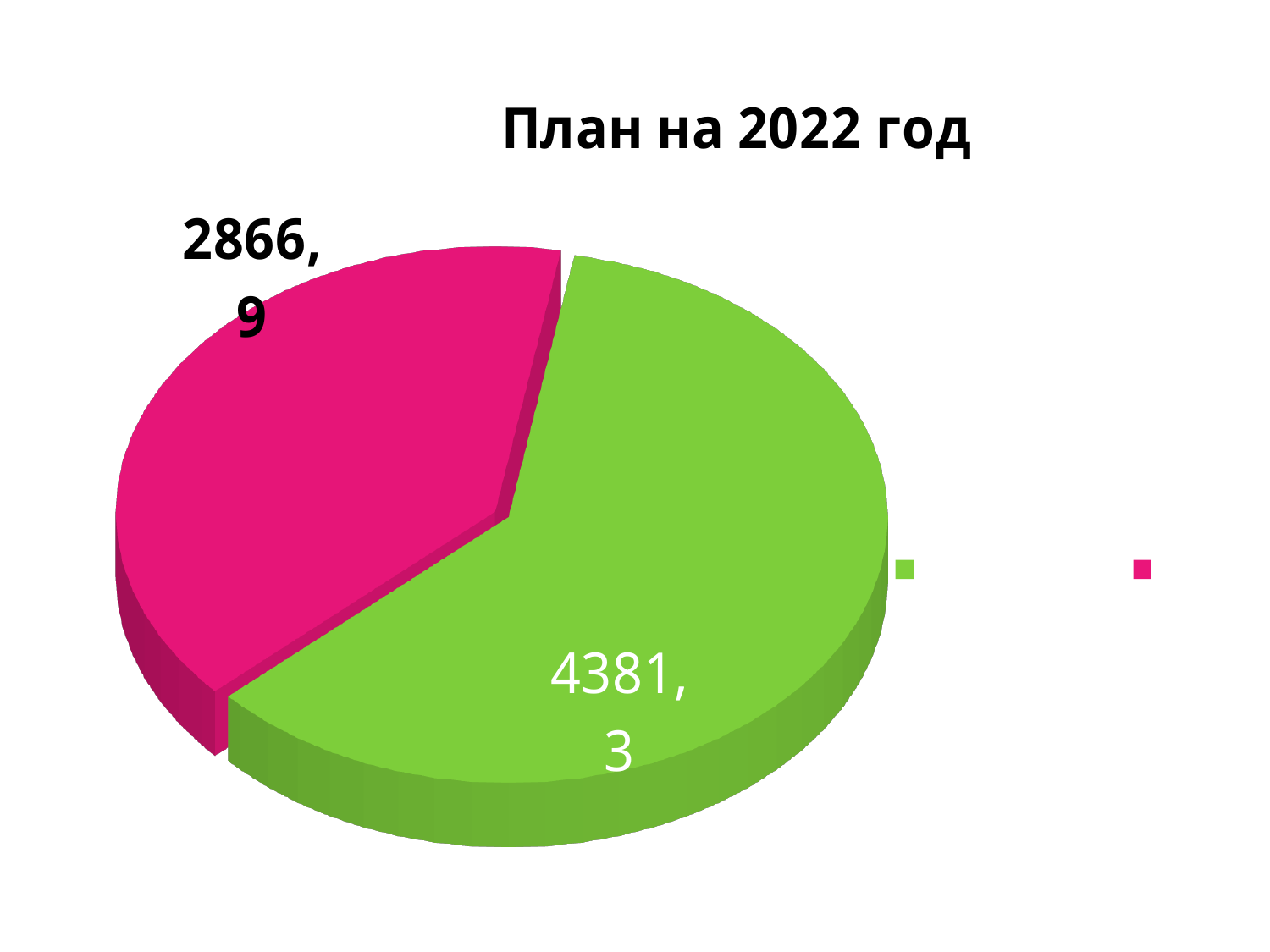
Is the value of the green slice larger or smaller than the value of the magenta slice? larger How many slices does the pie chart have? 2 What is the title of the chart? План на 2022 год What value is shown on the magenta slice of the pie chart? 2866,9 What kind of chart is shown on the slide? pie chart How many colour entries does the legend show? 2 What is the difference between the green slice value (4381,3) and the magenta slice value (2866,9)? 1514,4 What share of the pie does the green slice (4381,3) represent, to one decimal place? 60.4% Which slice of the pie chart has the largest value, the green one or the magenta one? the green one What is the total of the two values shown on the pie chart? 7248,2 Which slice of the pie chart has the smallest value, the green one or the magenta one? the magenta one What value is shown on the green slice of the pie chart? 4381,3